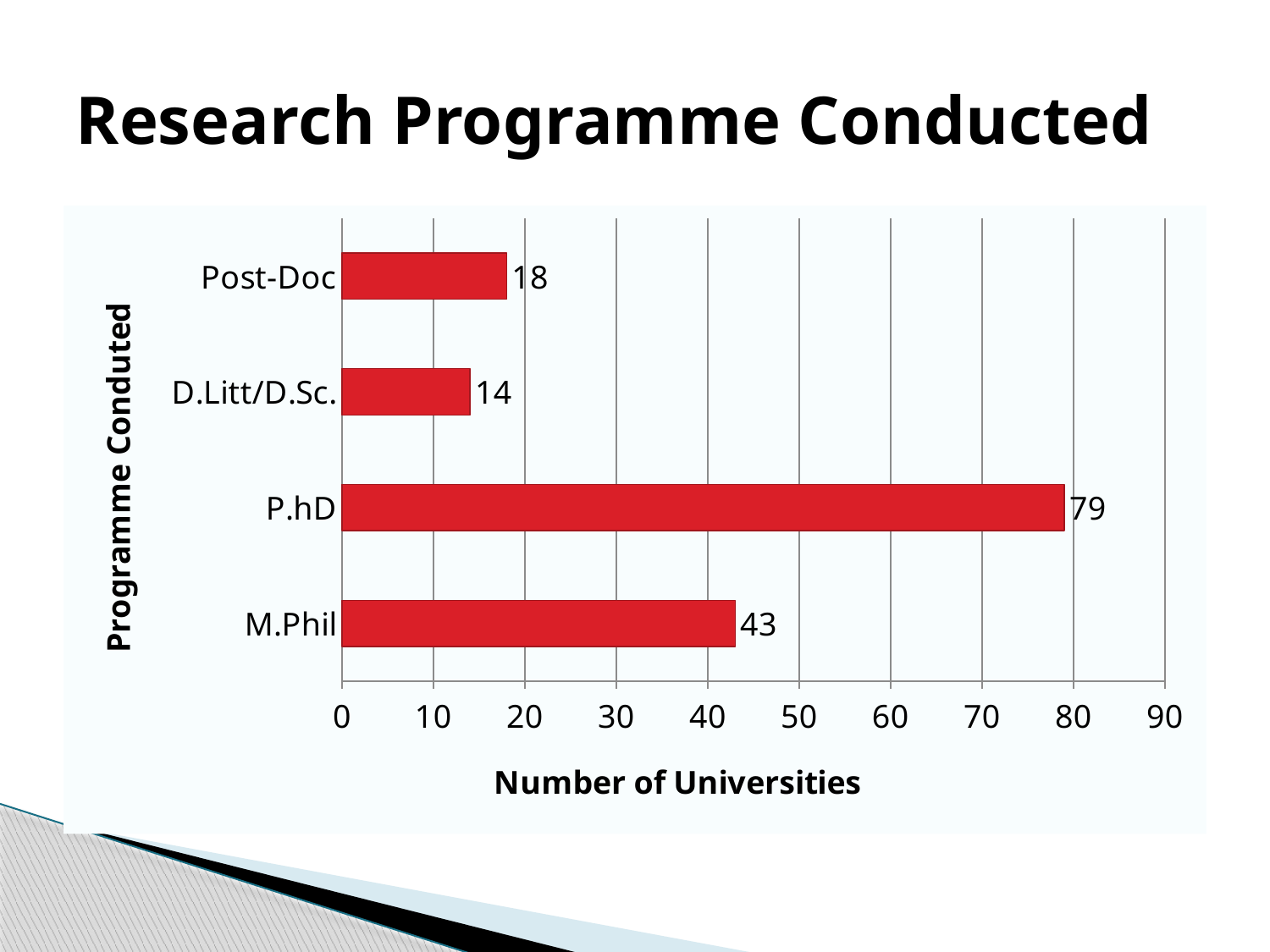
What is the difference between the values for Post-Doc and D.Litt/D.Sc.? 4 How many universities conduct P.hD programmes? 79 What is the value for M.Phil? 43 What is the label of the horizontal axis? Number of Universities What is the difference between the values for P.hD and M.Phil? 36 What is the number of universities for Post-Doc? 18 How many programme categories are shown in the chart? 4 Which programme has the lowest number of universities? D.Litt/D.Sc. Which has a larger value, M.Phil or Post-Doc? M.Phil What is the value for D.Litt/D.Sc.? 14 What type of chart is shown on the slide? Bar chart Which programme has the highest number of universities? P.hD